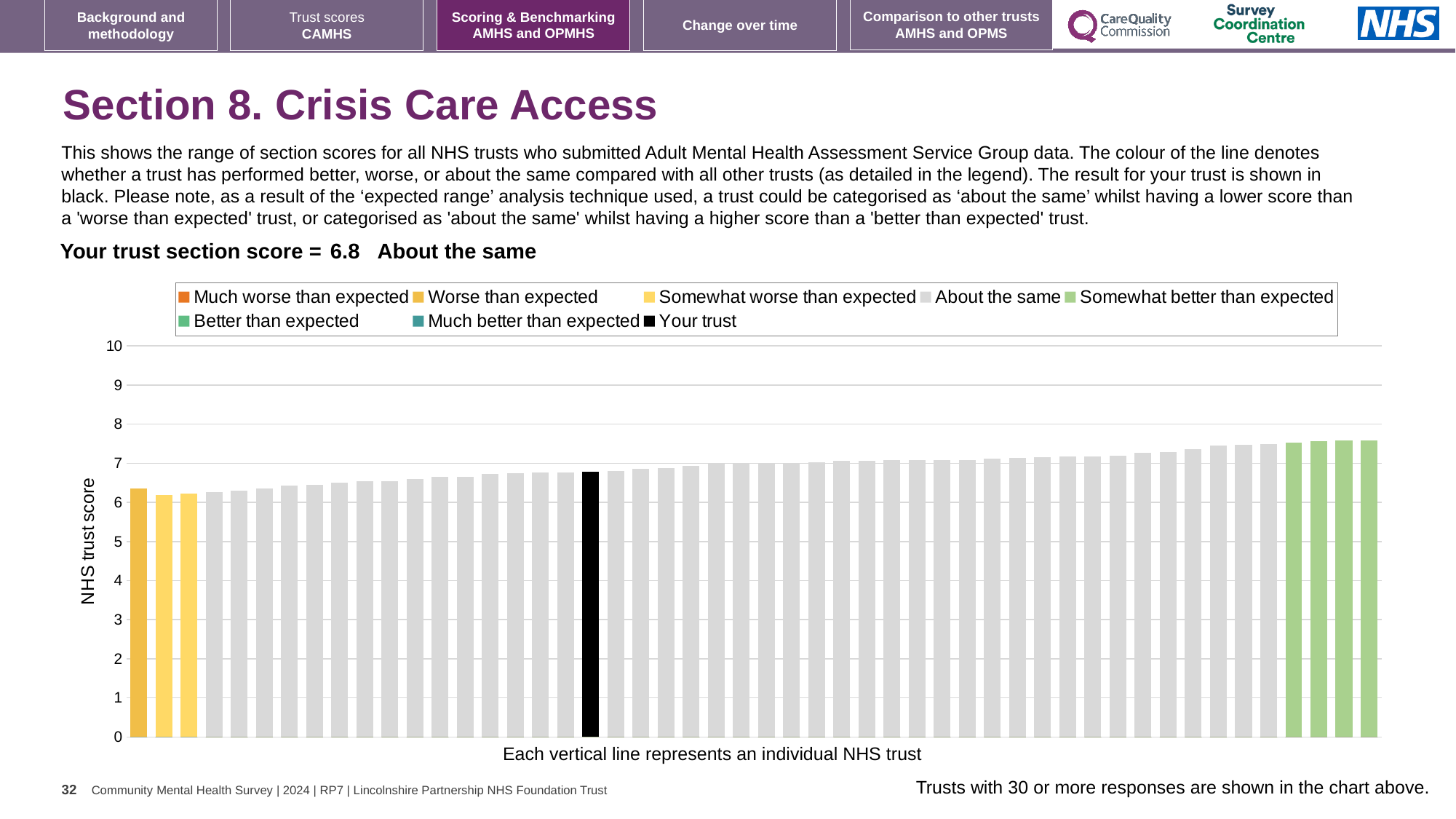
Is the value of the shortest bar greater or less than 6? greater Which category is your trust placed in for this section? About the same How many series does the chart legend list? 8 Is the value for your trust greater or less than 7? less What is the section score for your trust shown on the slide? 6.8 Is the value for your trust greater or less than 5? greater How many bars are coloured as 'Somewhat better than expected'? 4 Is the leftmost bar higher or lower than the rightmost bar? lower What is the label on the vertical axis of the chart? NHS trust score Do the bar values rise or fall from left to right along the x axis? rise What kind of chart is shown on the slide? bar chart